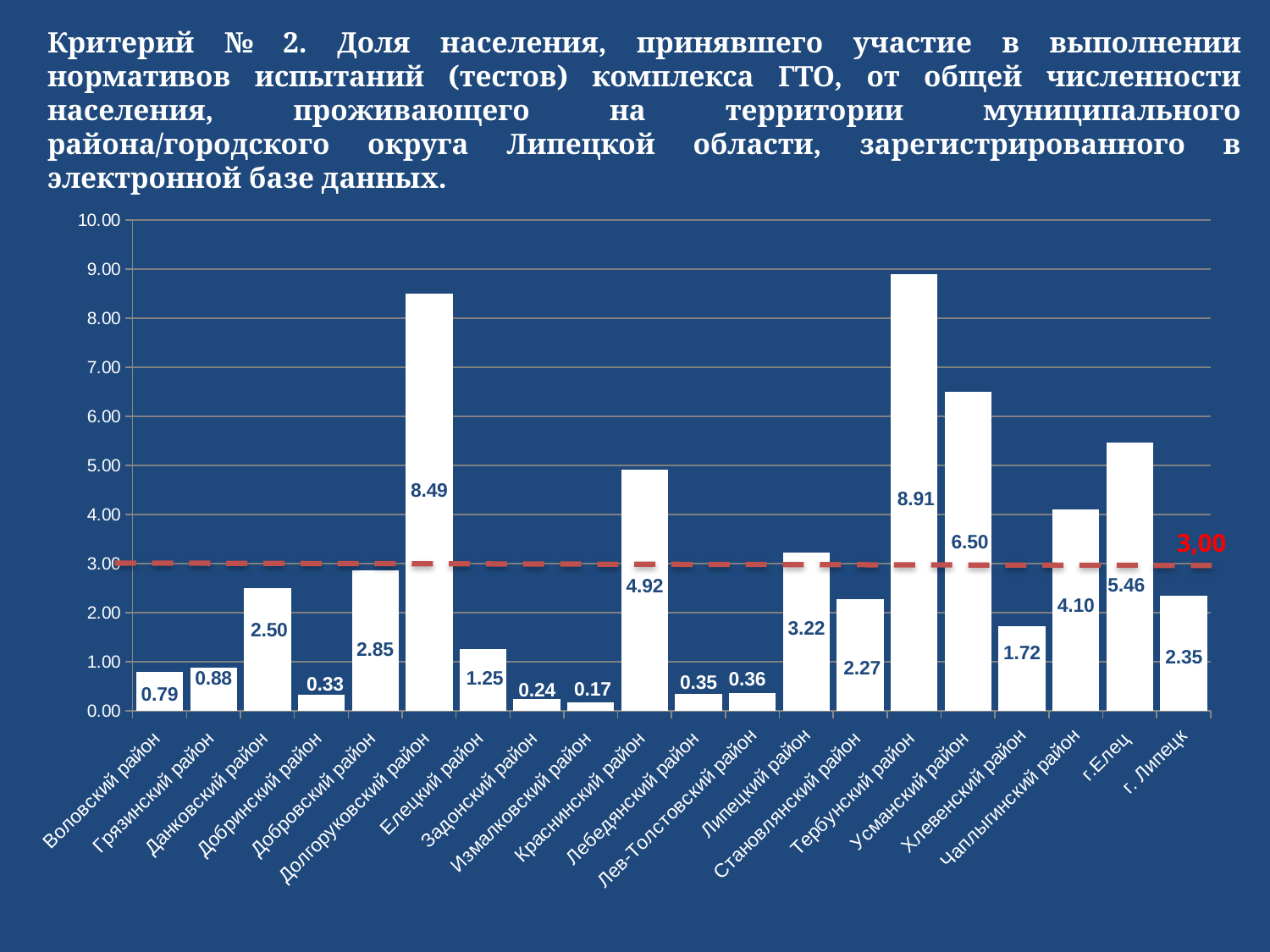
How many districts are shown on the x axis? 20 What is the difference between the values for Тербунский район and Долгоруковский район? 0.42 Which district has the highest value? Тербунский район Which is larger, the value for Данковский район or the value for Становлянский район? Данковский район What is the difference between the values for Усманский район and г.Елец? 1.04 Which district has the lowest value? Измалковский район What is the value for г. Липецк? 2.35 What value is labelled on the red dashed horizontal line? 3,00 What is the value for Краснинский район? 4.92 What kind of chart is shown on the slide? bar chart What is the value for Долгоруковский район? 8.49 Is the value for Чаплыгинский район greater or less than 3.00? greater